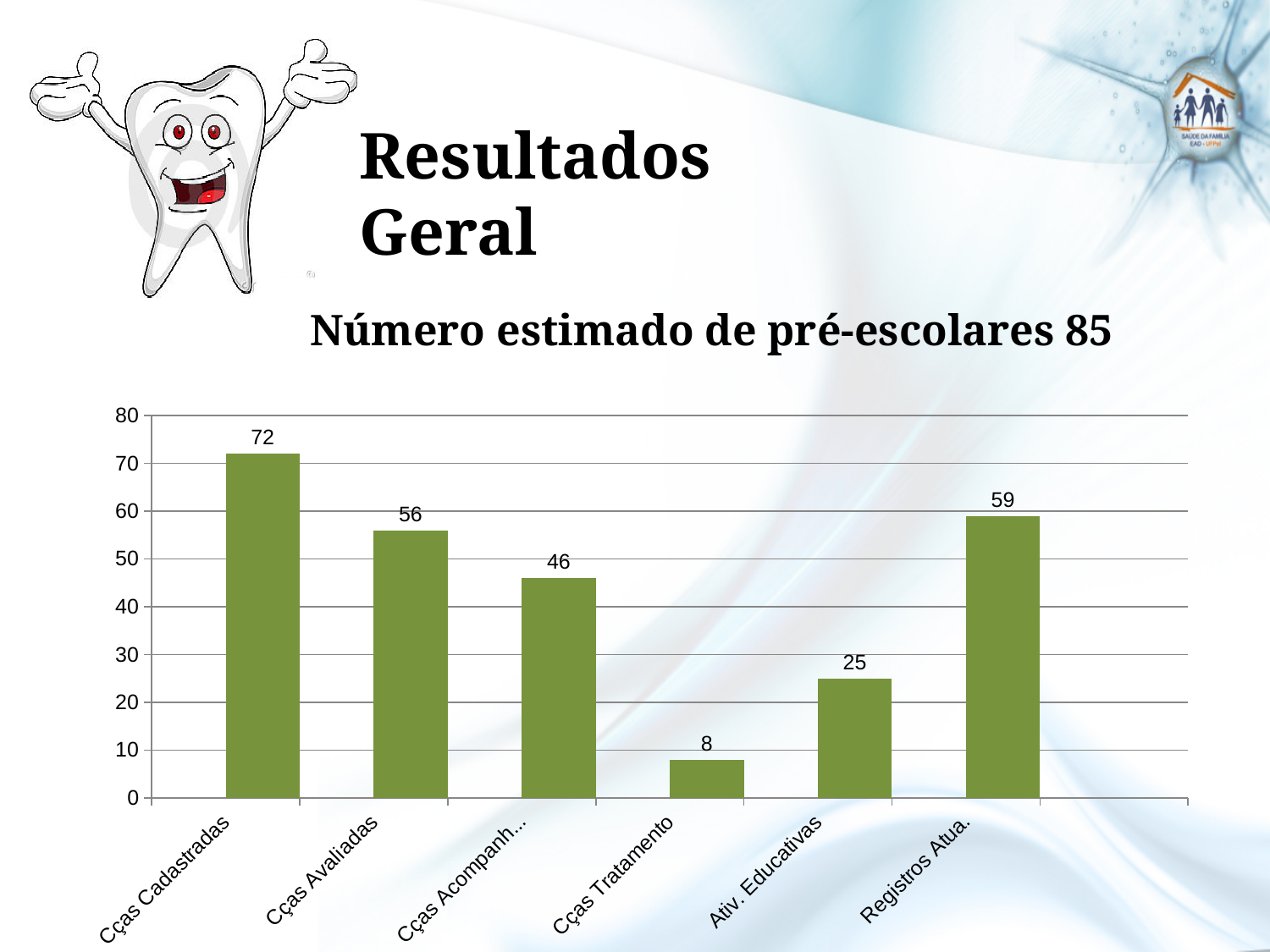
What is the value for Cças Tratamento? 8 What is the value for Registros Atua.? 59 Which is larger, the value for Registros Atua. or the value for Cças Avaliadas? Registros Atua. What is the difference between the values for Cças Cadastradas and Cças Avaliadas? 16 What is the value for Cças Cadastradas? 72 What is the value for Cças Avaliadas? 56 Which category has the lowest value? Cças Tratamento Which category has the highest value? Cças Cadastradas Is the value for Ativ. Educativas greater or less than 30? less How many categories are shown in the chart? 6 What kind of chart is shown on the slide? bar chart What is the value for Ativ. Educativas? 25